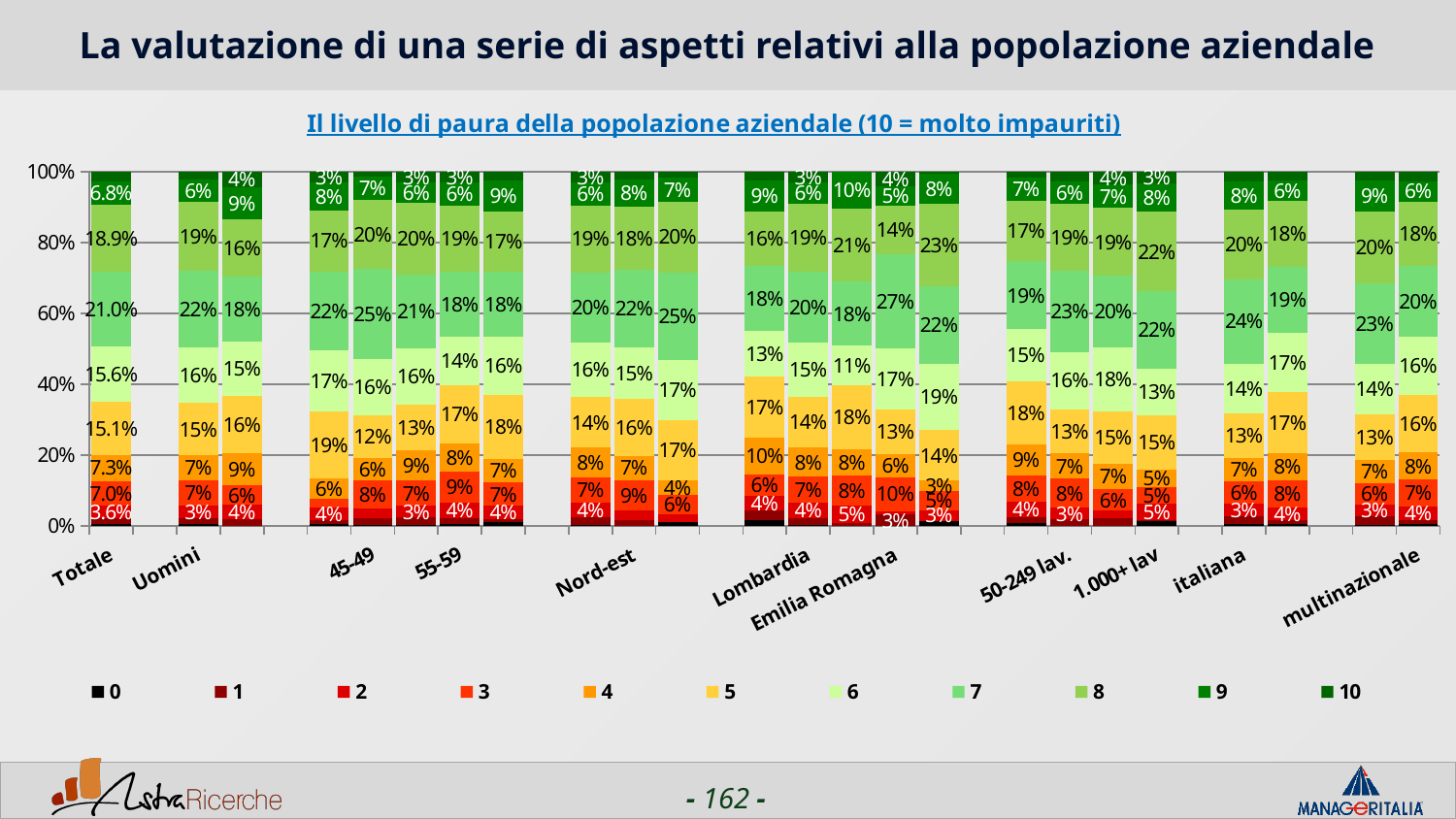
How many series does the legend list? 11 In the Totale bar, which is larger: series 8 or series 9? series 8 What kind of chart is shown on the slide? stacked bar chart What is the value of the top segment (series 10) in the Lombardia bar? 3% What is the value of series 8 in the Uomini bar? 19% What is the value of series 8 in the Totale bar? 18.9% What is the value of series 9 in the Totale bar? 6.8% What is the title of the chart? Il livello di paura della popolazione aziendale (10 = molto impauriti) Which series is the first entry in the legend? 0